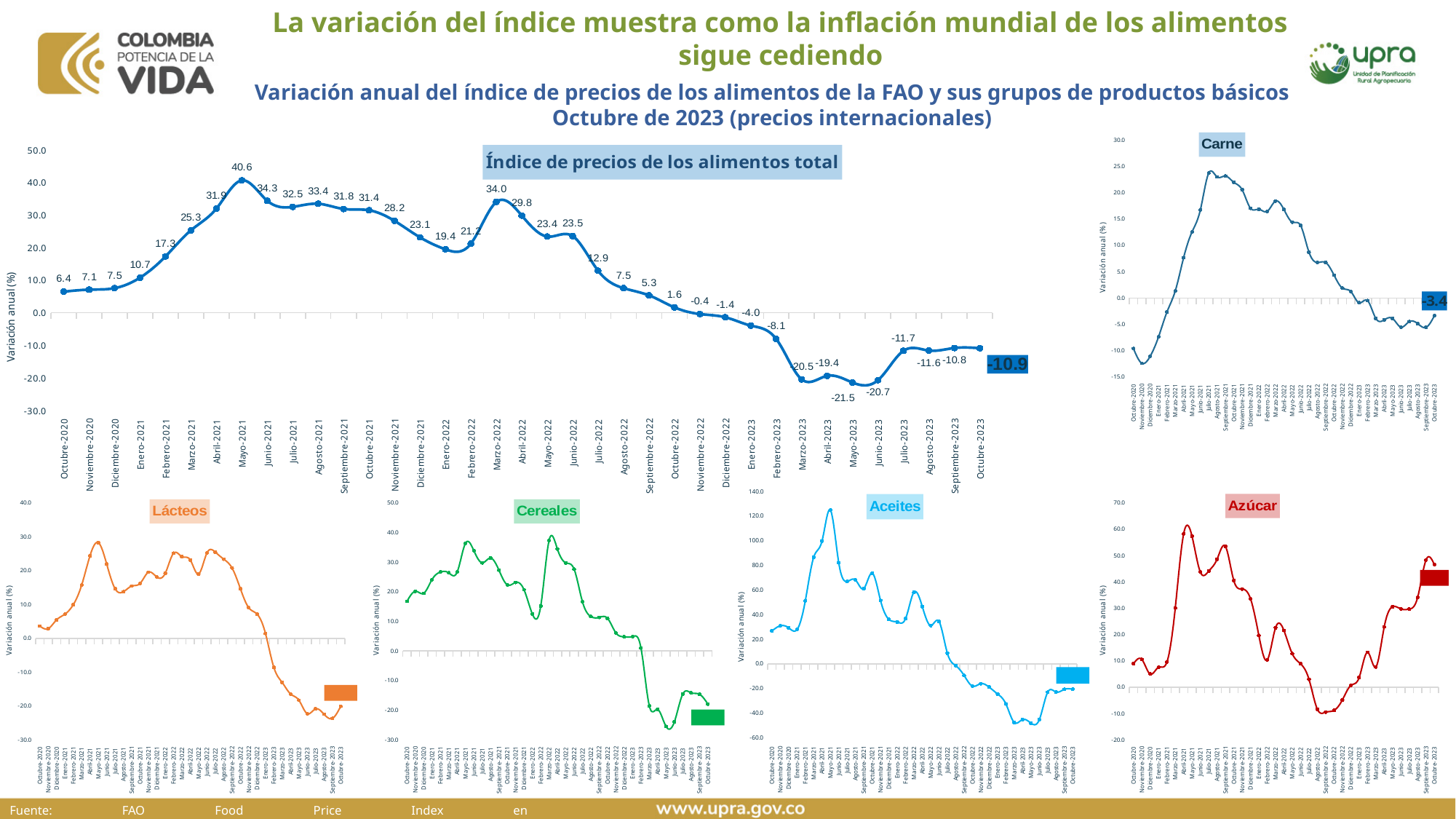
On the 'Índice de precios de los alimentos total' chart, which month has the lowest value? Mayo-2023 On the 'Carne' chart, is the peak value greater or less than 20.0? greater On the 'Índice de precios de los alimentos total' chart, what is the value for Marzo-2022? 34.0 On the 'Índice de precios de los alimentos total' chart, which is larger, the value for Abril-2022 or the value for Julio-2022? Abril-2022 On the 'Carne' chart, what is the value for Octubre-2023? -3.4 On the 'Índice de precios de los alimentos total' chart, is the value for Febrero-2021 greater or less than 20.0? less How many smaller product-group charts (besides the total index chart) are shown on the slide? 5 On the 'Índice de precios de los alimentos total' chart, what is the value for Mayo-2021? 40.6 On the 'Índice de precios de los alimentos total' chart, what is the value for Octubre-2023? -10.9 What kind of chart is the 'Índice de precios de los alimentos total' chart? line chart On the 'Índice de precios de los alimentos total' chart, what is the difference between the values for Mayo-2021 and Junio-2021? 6.3 On the 'Índice de precios de los alimentos total' chart, which month has the highest value? Mayo-2021